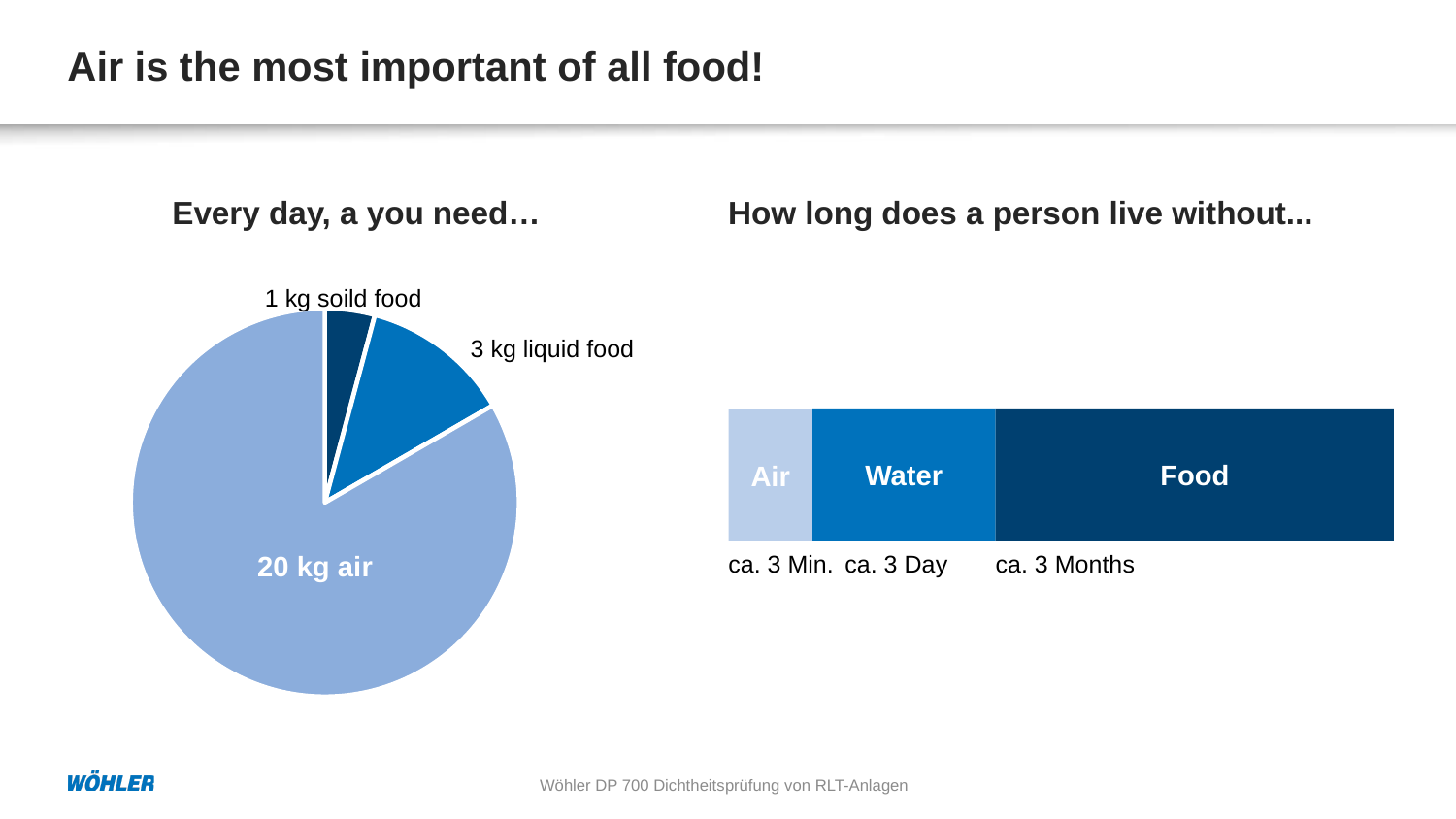
In the pie chart "Every day, a you need…", how many slices are there? 3 What type of chart is shown under the heading "Every day, a you need…"? pie chart In the pie chart "Every day, a you need…", how much air does a person need per day? 20 kg In the pie chart "Every day, a you need…", which is larger: the liquid food slice or the solid food slice? liquid food In the pie chart "Every day, a you need…", what is the total daily amount of air, liquid food and solid food combined? 24 kg In the pie chart "Every day, a you need…", how much solid food does a person need per day? 1 kg In the pie chart "Every day, a you need…", which slice is the smallest? solid food In the pie chart "Every day, a you need…", how much liquid food does a person need per day? 3 kg In the chart "How long does a person live without...", which segment is the longest? Food In the pie chart "Every day, a you need…", which slice is the largest? air In the pie chart "Every day, a you need…", how much more air than liquid food does a person need per day? 17 kg In the chart "How long does a person live without...", how many segments does the bar have? 3